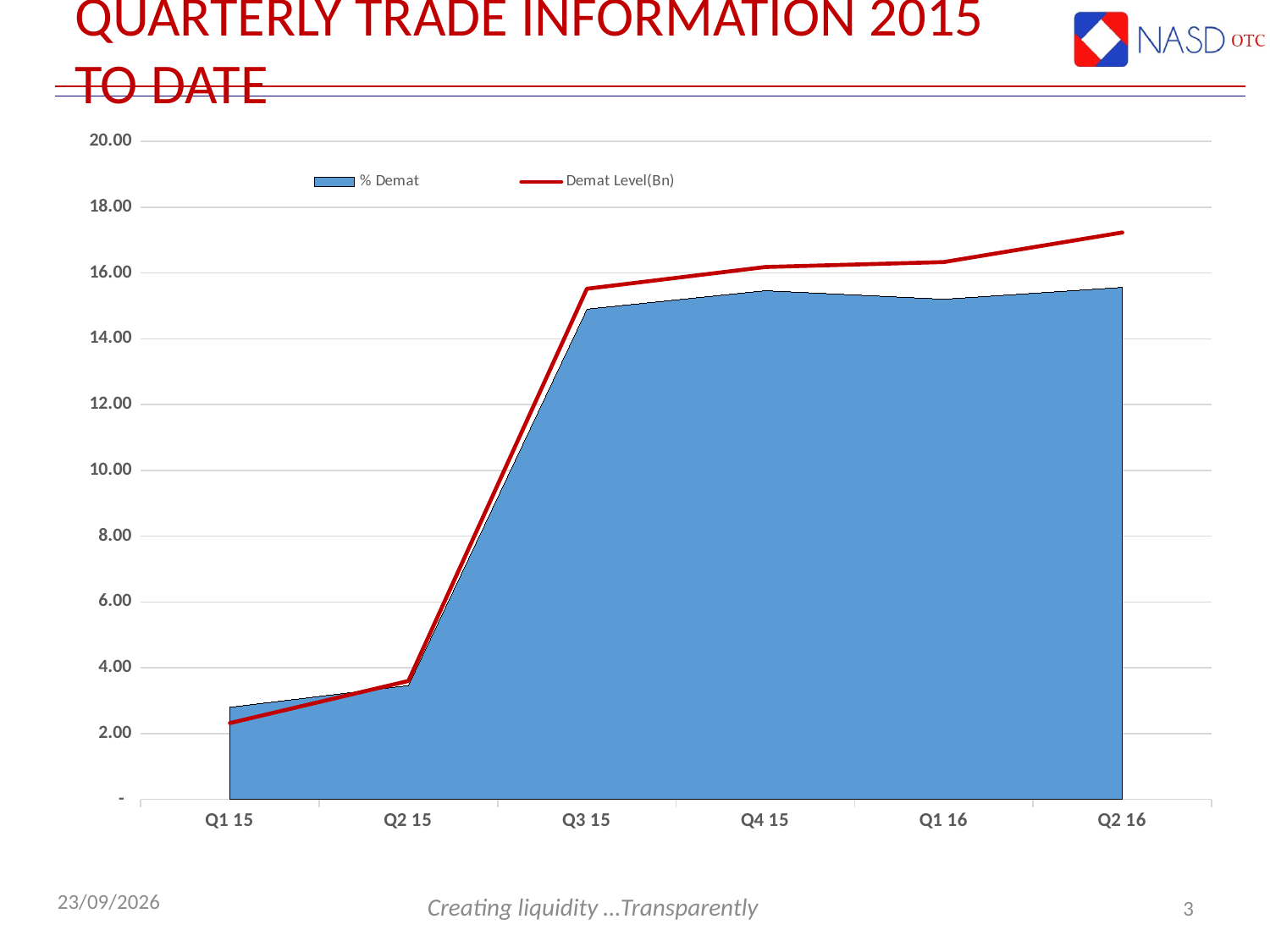
What are the two series named in the chart legend? % Demat and Demat Level(Bn) Is the % Demat value for Q2 15 greater or less than 6.00? less Is the Demat Level(Bn) value for Q2 16 greater or less than 16.00? greater In which quarter is the Demat Level(Bn) line at its lowest? Q1 15 Is the Demat Level(Bn) value for Q3 15 greater or less than 14.00? greater Between which two consecutive quarters does the % Demat series show its largest increase? Q2 15 to Q3 15 Does the Demat Level(Bn) line generally rise or fall from Q1 15 to Q2 16? Rise Which is larger, the % Demat value for Q2 15 or the % Demat value for Q3 15? Q3 15 What kind of chart is shown on the slide? A combined area and line chart How many series does the chart legend list? 2 In which quarter is the Demat Level(Bn) line at its highest? Q2 16 How many quarters are shown on the x axis of the chart? 6